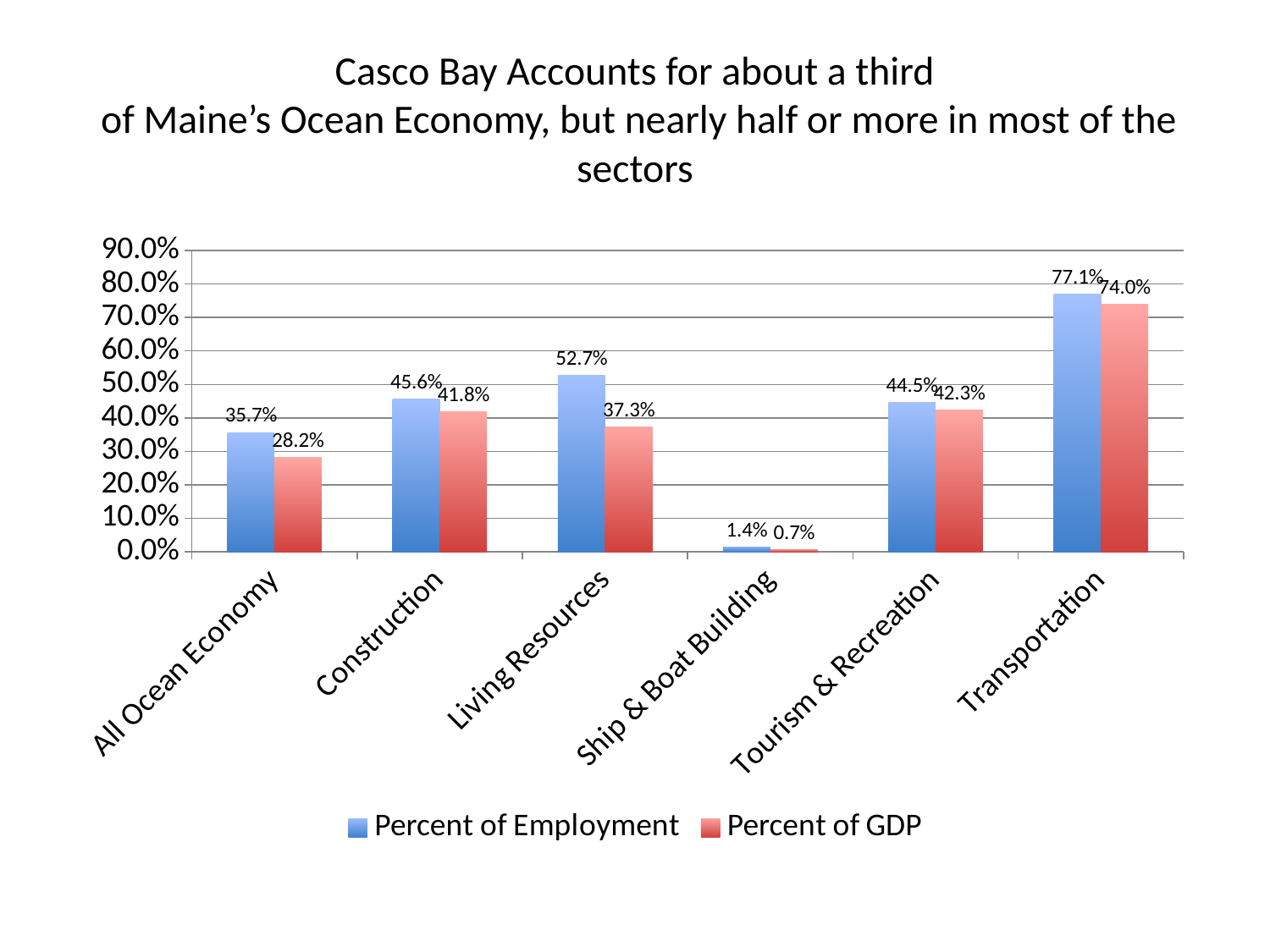
What is the Percent of Employment for Living Resources? 52.7% What is the difference between Percent of Employment and Percent of GDP for Living Resources? 15.4% Which is larger for Tourism & Recreation: Percent of Employment or Percent of GDP? Percent of Employment How many categories are shown on the x axis? 6 How many series does the legend list? 2 Which category has the lowest Percent of GDP? Ship & Boat Building Is the Percent of Employment for Transportation greater or less than 70.0%? greater What colour are the Percent of GDP bars? red What is the Percent of GDP for Construction? 41.8% Which category has the highest Percent of Employment? Transportation What is the Percent of GDP for All Ocean Economy? 28.2% What kind of chart is shown on the slide? bar chart